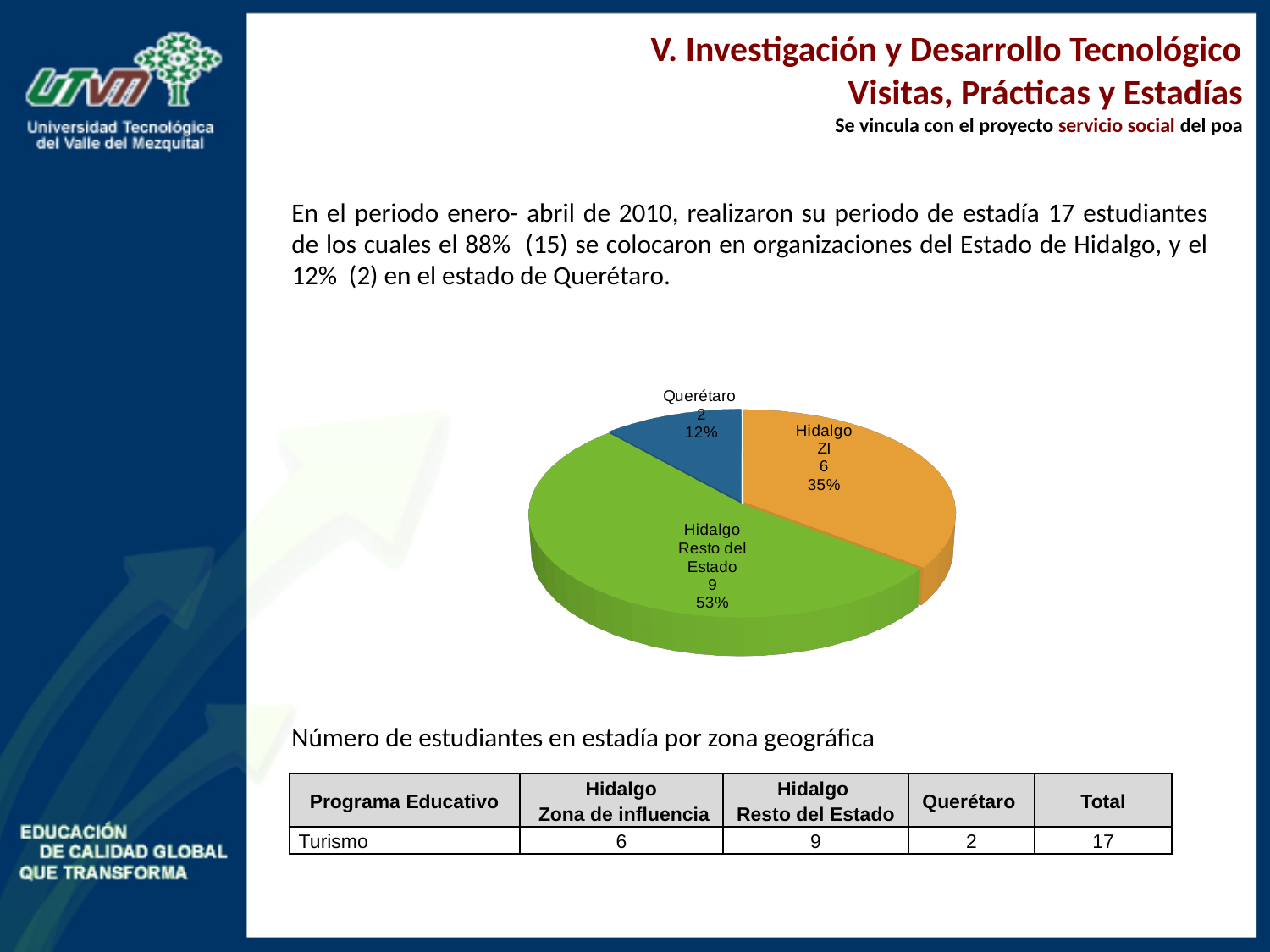
How many slices does the pie chart have? 3 Which slice is larger, Hidalgo ZI or Querétaro? Hidalgo ZI What percentage share does the Querétaro slice represent? 12% What is the value shown for the Querétaro slice? 2 What is the value shown for the Hidalgo ZI slice? 6 What kind of chart is shown on the slide? Pie chart Which slice of the pie chart is the smallest? Querétaro Which slice of the pie chart is the largest? Hidalgo Resto del Estado What percentage share does the Hidalgo ZI slice represent? 35% What is the value shown for the Hidalgo Resto del Estado slice? 9 What percentage share does the Hidalgo Resto del Estado slice represent? 53% What is the difference between the Hidalgo Resto del Estado value and the Hidalgo ZI value? 3